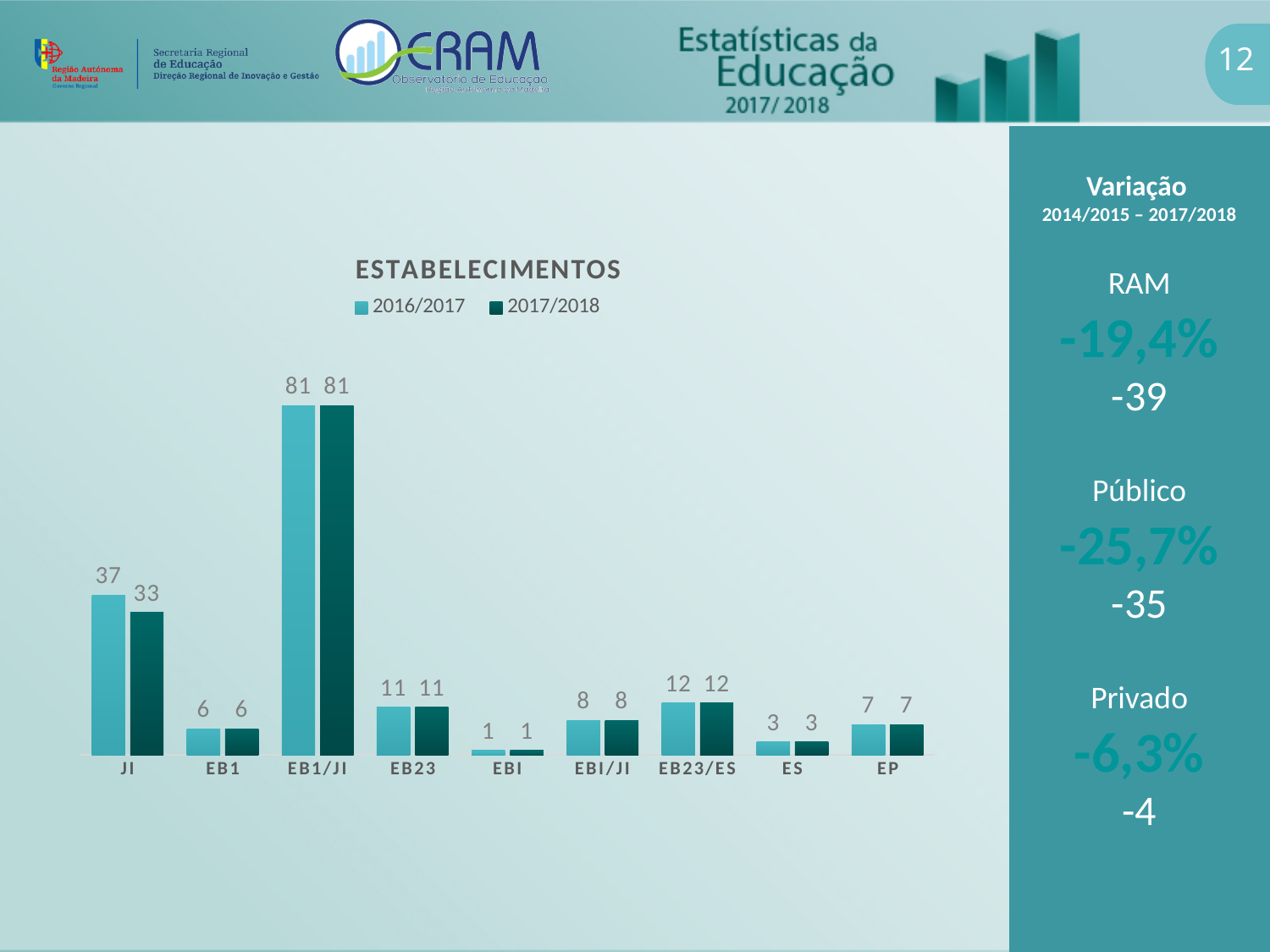
How many categories are shown on the x axis of the chart? 9 How many series does the legend list? 2 Which category has the lowest value in the 2016/2017 series? EBI What type of chart is shown on the slide? Bar chart Which category has a larger 2017/2018 value, EBI/JI or ES? EBI/JI Which is larger for EB23: the 2016/2017 value or the 2017/2018 value? They are equal (11) What is the value for JI in the 2017/2018 series? 33 What is the difference between the 2016/2017 and 2017/2018 values for JI? 4 Which category has the highest value in the 2017/2018 series? EB1/JI What is the value for EP in the 2016/2017 series? 7 What is the value for JI in the 2016/2017 series? 37 What is the value for EB23/ES in the 2017/2018 series? 12